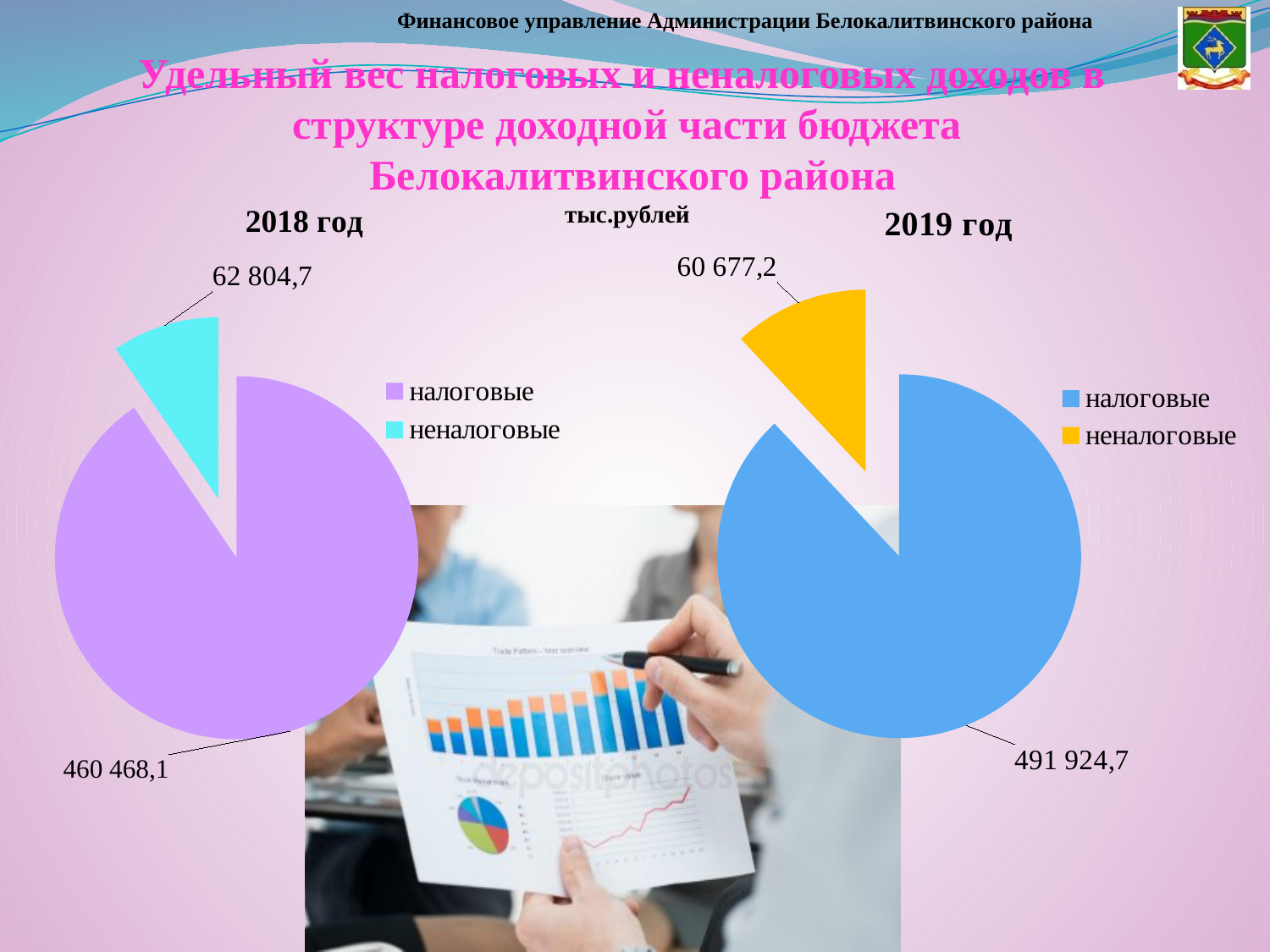
What type of chart is used for the 2019 год data? pie chart On the 2018 год chart, what is the difference between налоговые and неналоговые? 397 663,4 On the 2019 год chart, which category has the smallest slice? неналоговые On the 2018 год chart, which category has the largest slice? налоговые On the 2019 год chart, what is the value for налоговые? 491 924,7 On the 2018 год chart, what is the value for налоговые? 460 468,1 On the 2018 год chart, what is the value for неналоговые? 62 804,7 How many categories does the 2018 год chart show? 2 Which is larger: налоговые on the 2019 год chart or налоговые on the 2018 год chart? налоговые on the 2019 год chart On the 2019 год chart, what is the difference between налоговые and неналоговые? 431 247,5 On the 2019 год chart, what is the value for неналоговые? 60 677,2 On the 2019 год chart, what colour is the неналоговые slice? yellow